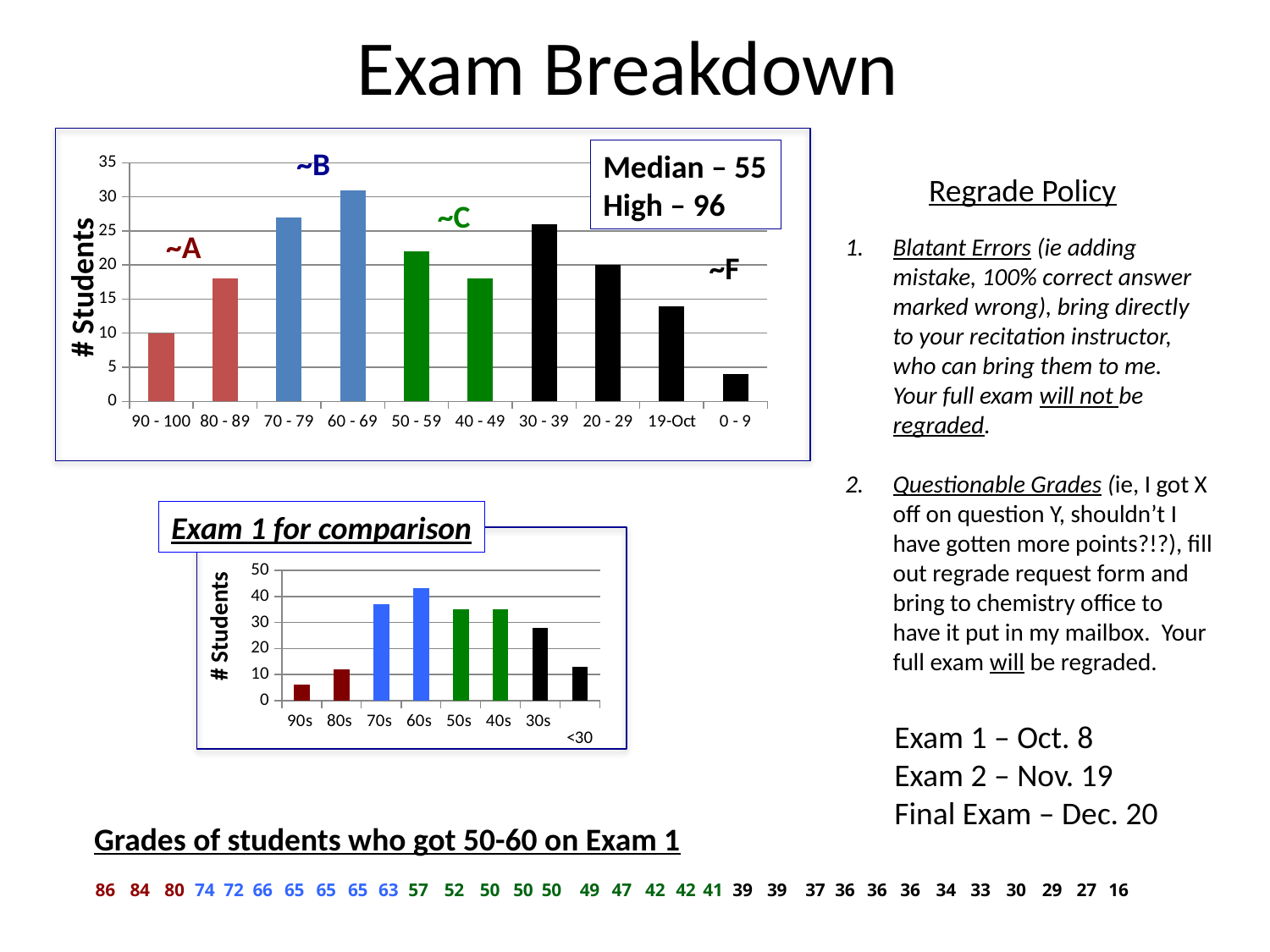
In the top chart, is the value for 40 - 49 greater or less than 20? less In the 'Exam 1 for comparison' chart, which category has the highest number of students? 60s In the top chart, which score range has the lowest number of students? 0 - 9 In the top chart, how many score-range categories are shown on the x axis? 10 What kind of chart is the top chart on the slide? bar chart In the top chart, which score range has the highest number of students? 60 - 69 In the 'Exam 1 for comparison' chart, which category has the lowest number of students? 90s In the 'Exam 1 for comparison' chart, is the value for 70s greater or less than 30? greater In the top chart, which has more students: 30 - 39 or 20 - 29? 30 - 39 In the top chart, is the value for 70 - 79 greater or less than 25? greater In the 'Exam 1 for comparison' chart, how many categories are shown on the x axis? 8 What median value is shown in the box on the top chart? 55